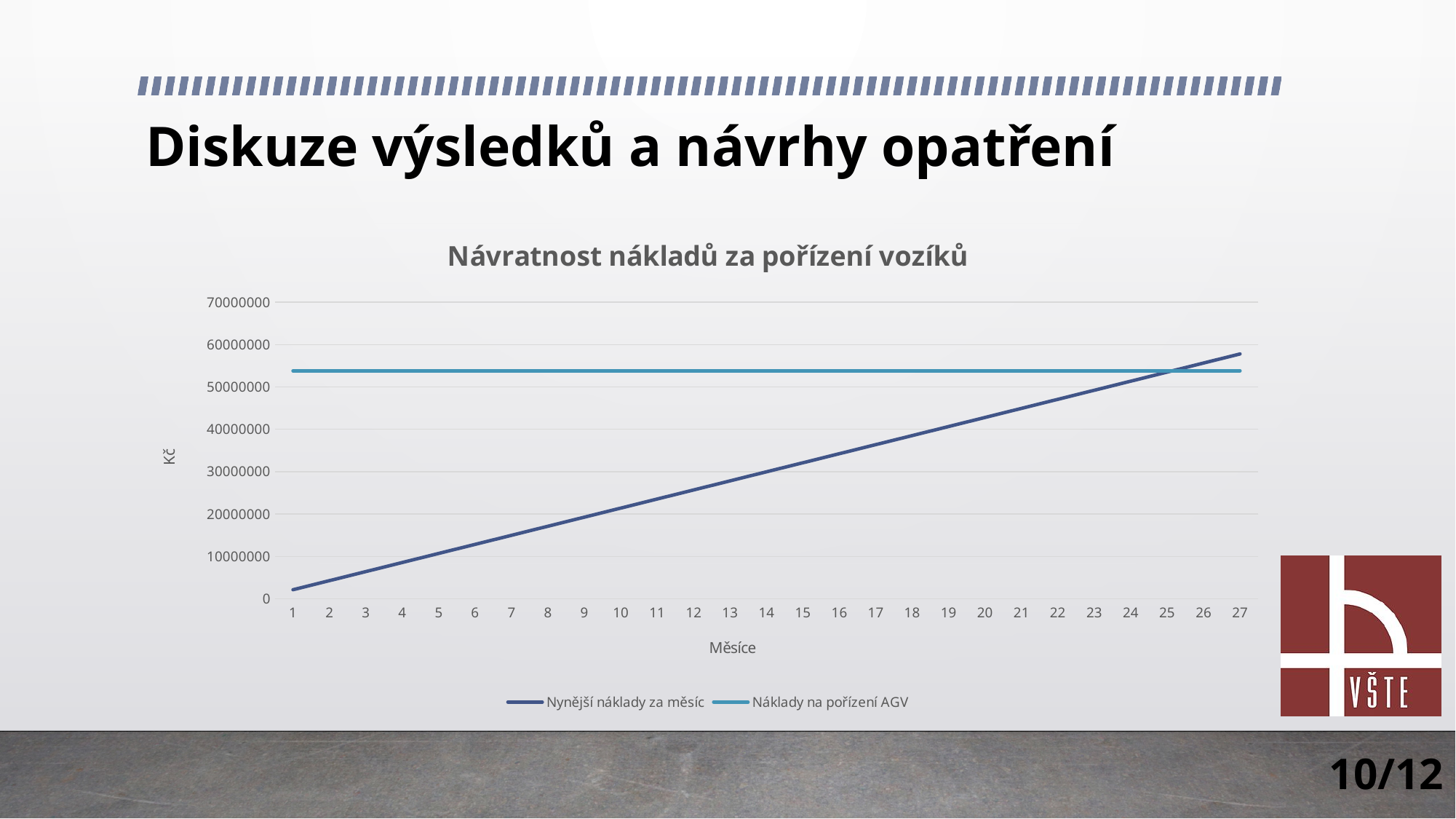
At month 10, which series has the higher value, 'Nynější náklady za měsíc' or 'Náklady na pořízení AGV'? Náklady na pořízení AGV How many months are shown on the x axis? 27 At month 27, which series has the higher value, 'Nynější náklady za měsíc' or 'Náklady na pořízení AGV'? Nynější náklady za měsíc Does the 'Nynější náklady za měsíc' line rise or fall as the months increase? Rises How many series does the legend list? 2 Does the 'Náklady na pořízení AGV' line rise, fall or stay flat across the months? Stays flat What kind of chart is shown on the slide? Line chart What is the label of the x axis of the chart? Měsíce What is the title of the chart? Návratnost nákladů za pořízení vozíků Is the value of 'Náklady na pořízení AGV' greater or less than 60000000? less Is the value of 'Nynější náklady za měsíc' at month 1 greater or less than 10000000? less Is the value of 'Nynější náklady za měsíc' at month 27 greater or less than 50000000? greater